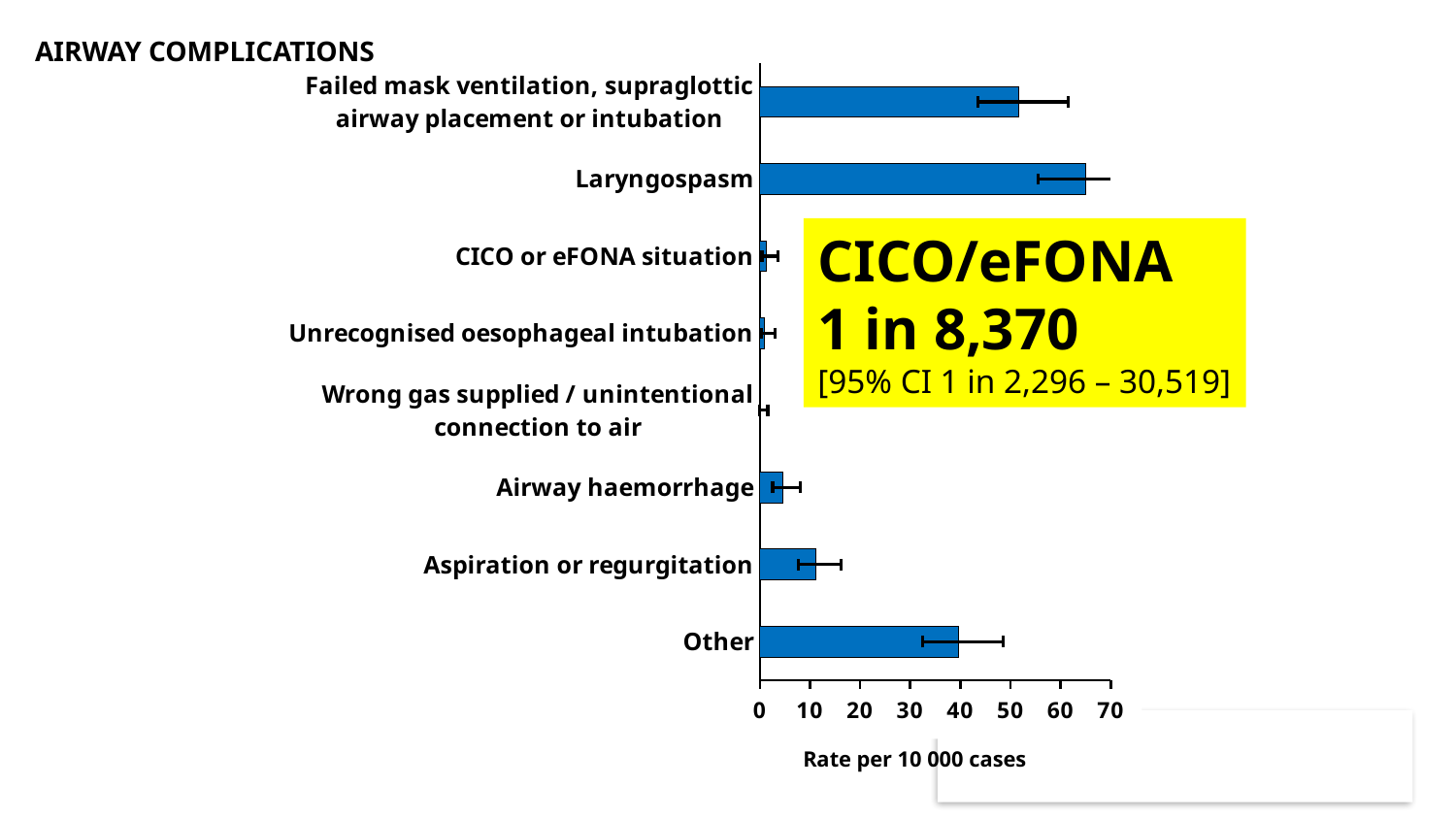
Which has a higher rate: Other or Aspiration or regurgitation? Other Is the rate for Airway haemorrhage greater or less than 10 per 10 000 cases? less What kind of chart is shown on the slide? Bar chart What is the label of the horizontal axis of the chart? Rate per 10 000 cases Is the rate for Failed mask ventilation, supraglottic airway placement or intubation greater or less than 40 per 10 000 cases? greater Which airway complication has the highest rate per 10 000 cases? Laryngospasm Is the rate for Other greater or less than 50 per 10 000 cases? less According to the highlighted callout on the slide, what is the rate of CICO/eFONA? 1 in 8,370 Which has a higher rate: Laryngospasm or Failed mask ventilation, supraglottic airway placement or intubation? Laryngospasm How many airway complication categories are plotted in the chart? 8